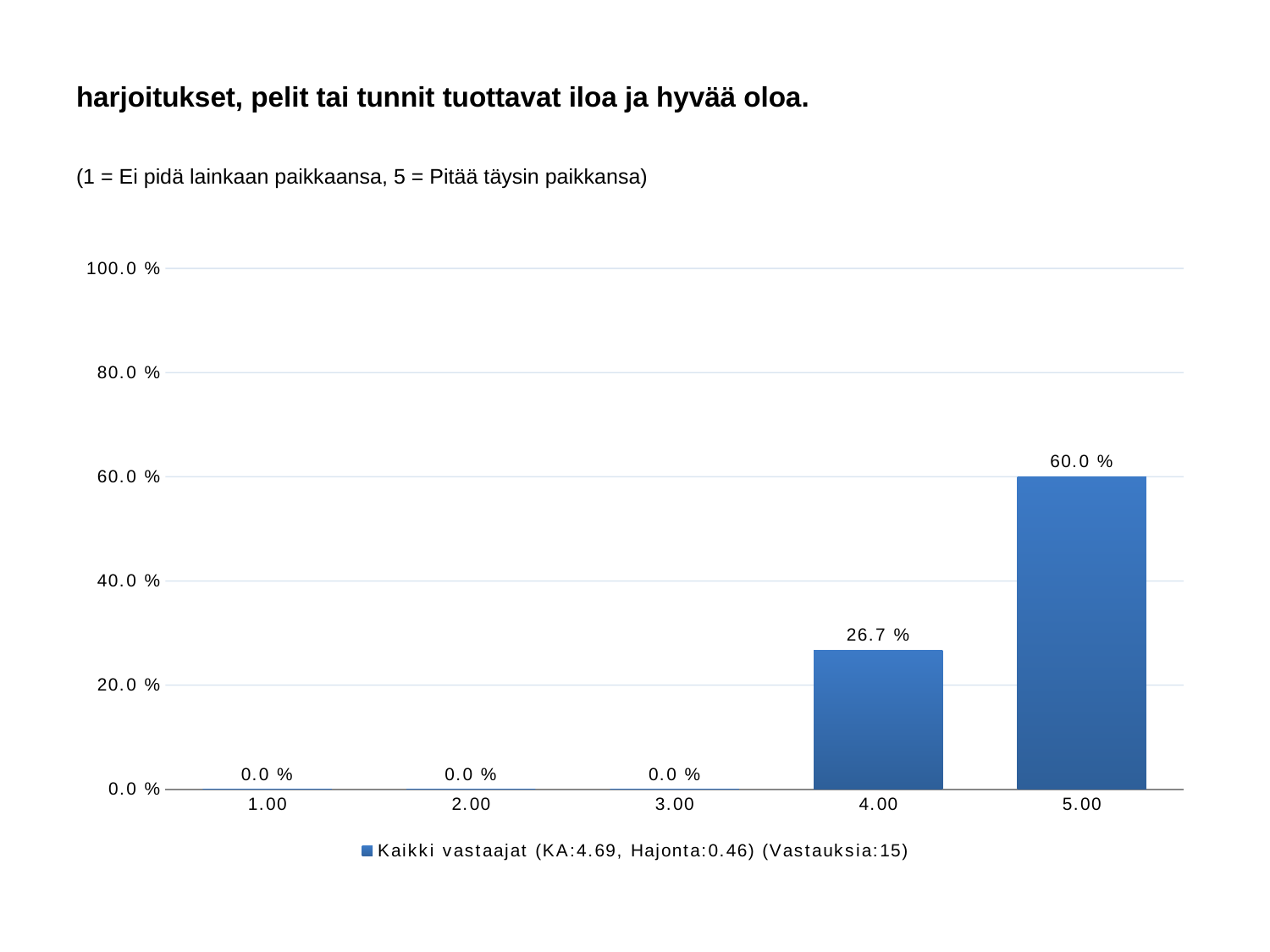
How many categories have a value of 0.0 %? 3 What is the value for category 4.00? 26.7 % Do the values rise or fall from category 1.00 to 5.00? rise What is the value for category 1.00? 0.0 % What kind of chart is shown? bar chart How many series does the legend list? 1 Which is larger, the value for 4.00 or the value for 5.00? 5.00 What is the value for category 5.00? 60.0 % What is the difference between the values for 5.00 and 4.00? 33.3 % Which category has the highest value? 5.00 Is the value for 4.00 greater or less than 40.0 %? less How many categories are shown on the x axis? 5